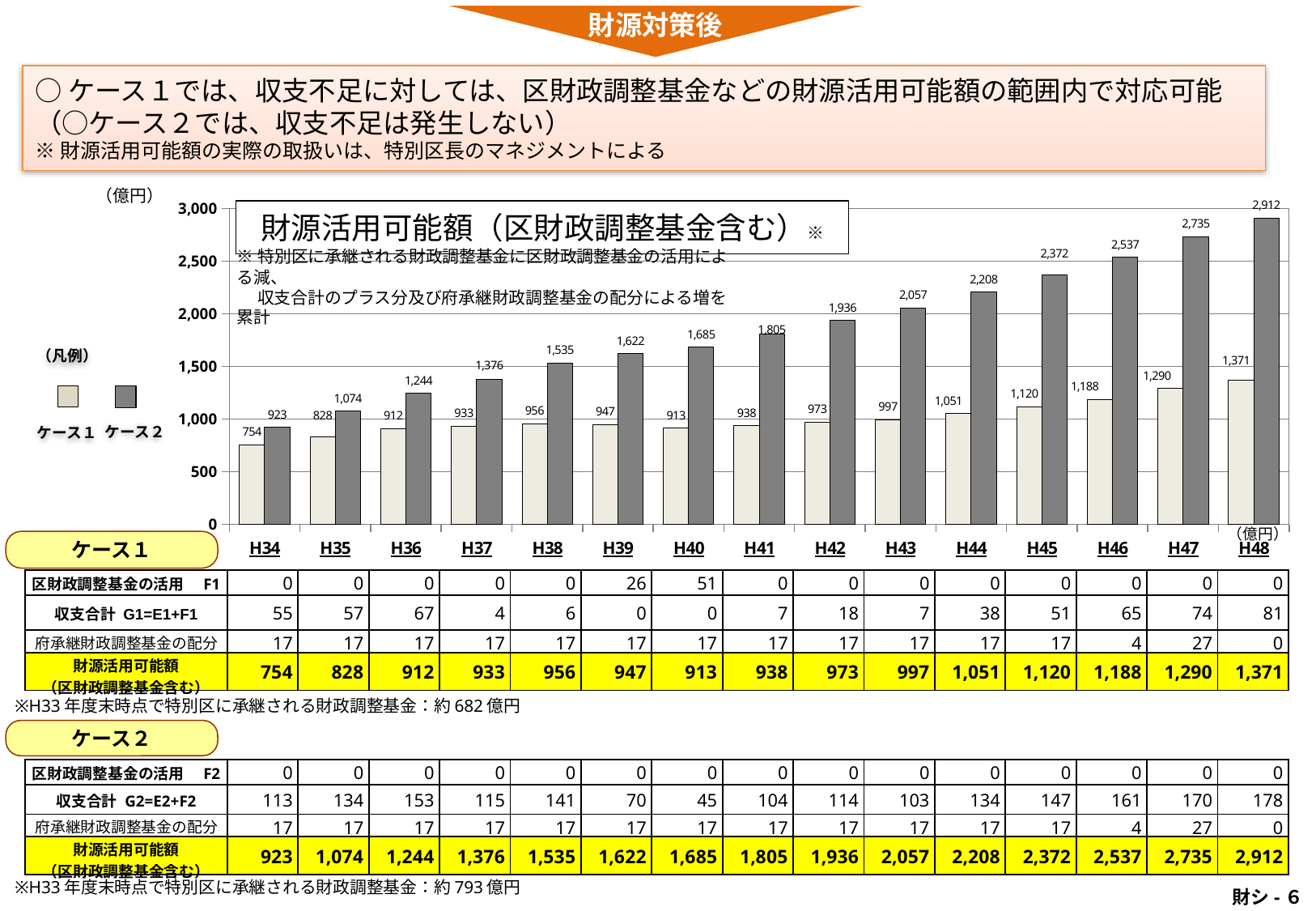
How many series does the legend list? 2 Do the values for ケース２ rise or fall from H34 to H48? rise How many years are shown on the x axis? 15 What is the value for ケース２ in H40? 1,685 Which year has the lowest value for ケース１? H34 Which year has the highest value for ケース２? H48 What is the title of the chart? 財源活用可能額（区財政調整基金含む） What is the value for ケース１ in H37? 933 Is the value for ケース２ in H42 greater or less than 2,000? less What kind of chart is shown? bar chart Which is larger in H44: ケース１ or ケース２? ケース２ What is the difference between ケース２ and ケース１ in H48? 1,541